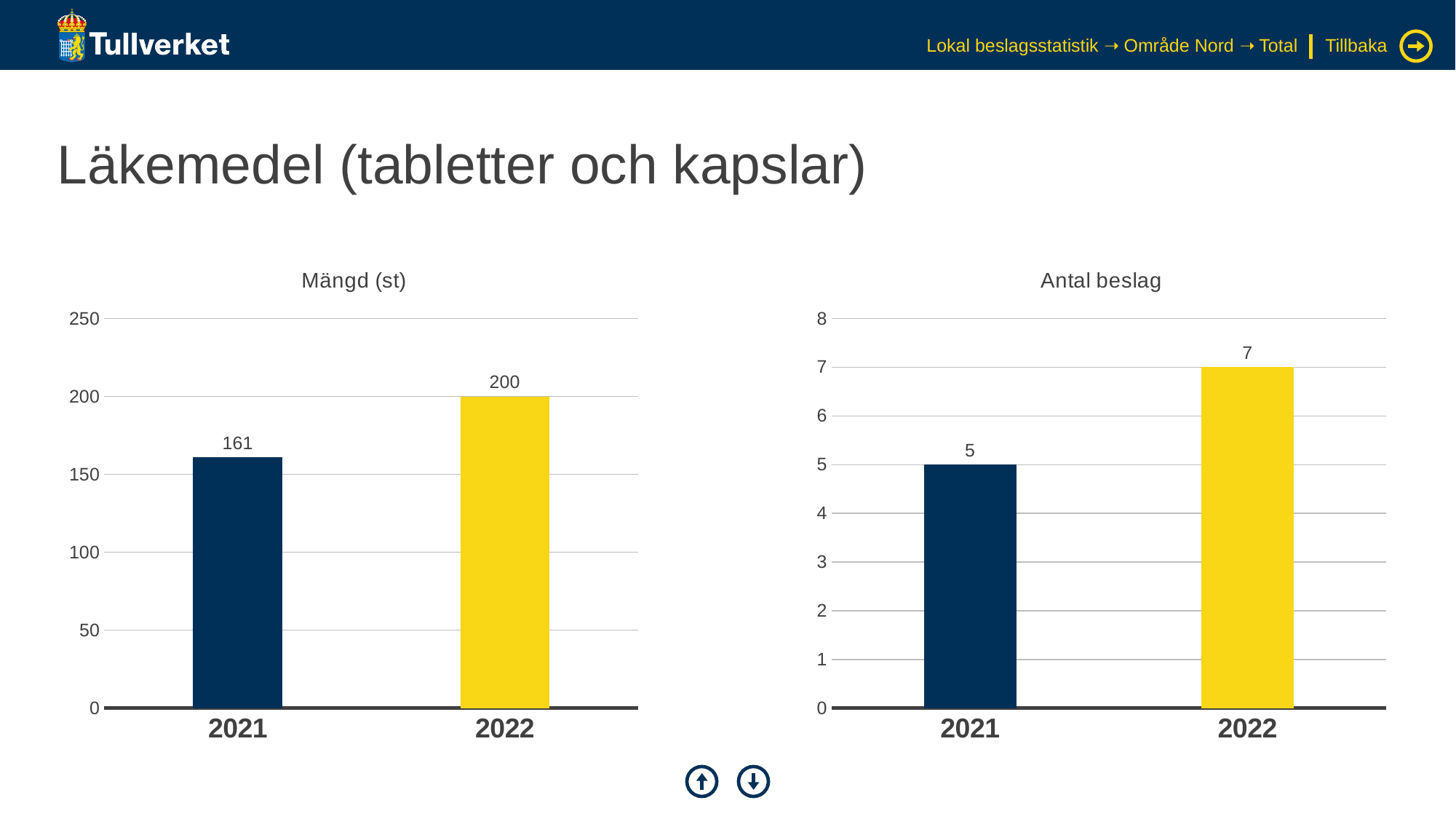
In the 'Mängd (st)' chart, what is the difference between the 2022 and 2021 values? 39 How many categories are shown on the x axis of the 'Mängd (st)' chart? 2 In the 'Mängd (st)' chart, what is the value for 2022? 200 In the 'Antal beslag' chart, what is the difference between the 2022 and 2021 values? 2 In the 'Mängd (st)' chart, what is the value for 2021? 161 In the 'Antal beslag' chart, what is the value for 2022? 7 What kind of chart is the 'Antal beslag' chart? bar chart In the 'Mängd (st)' chart, which year has the highest value? 2022 In the 'Antal beslag' chart, what is the value for 2021? 5 In the 'Antal beslag' chart, which year has the lowest value? 2021 In the 'Antal beslag' chart, is the value for 2021 greater or less than 6? less In the 'Mängd (st)' chart, do the values rise or fall from 2021 to 2022? rise